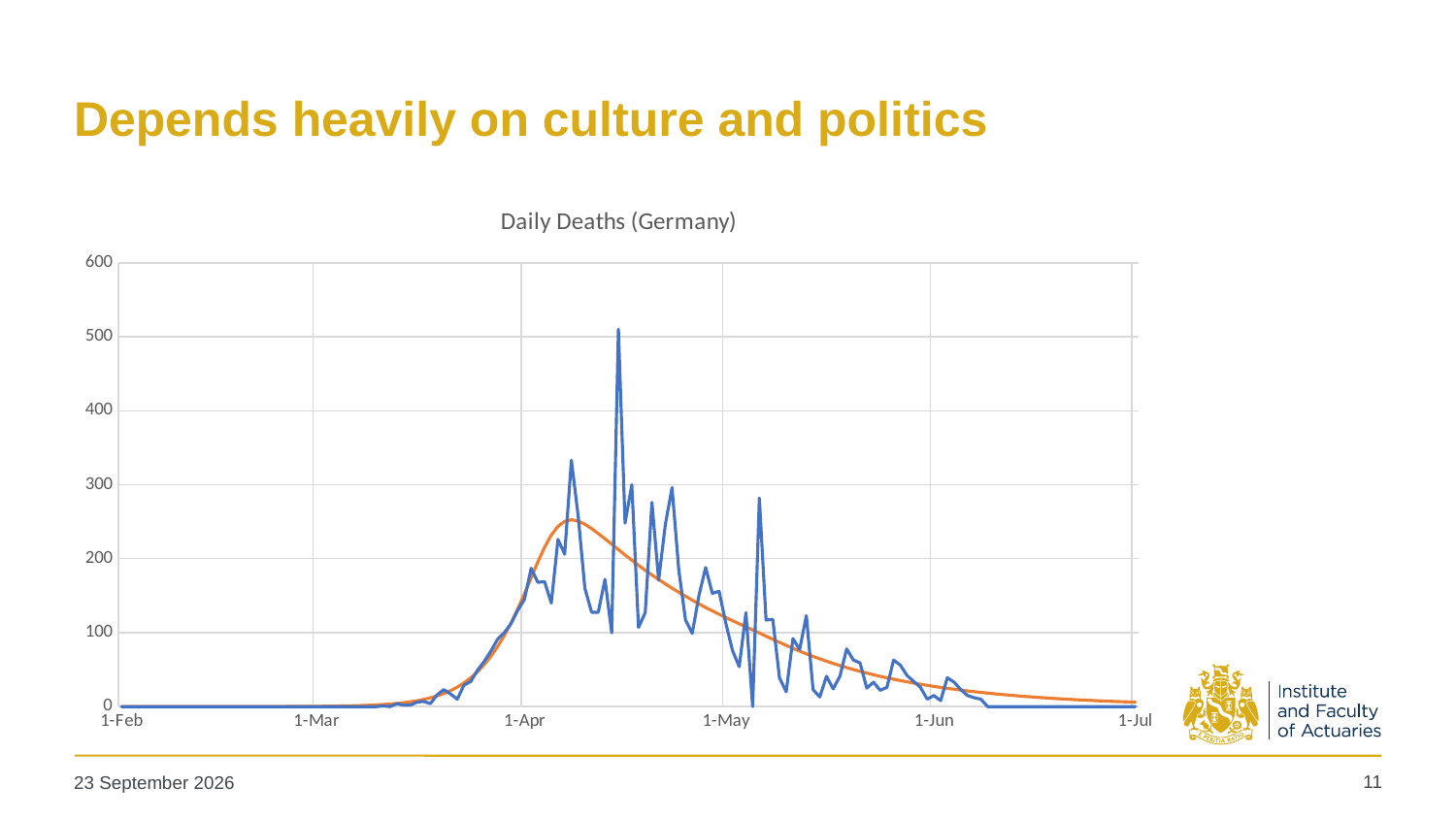
Is the peak of the orange smooth line greater or less than 200? greater Is the value of the orange line at 1-Jun greater or less than 100? less Does the orange line rise or fall between 1-May and 1-Jul? fall Is the peak of the orange smooth line greater or less than 300? less How many lines are plotted on the chart? 2 Does the orange line rise or fall between 1-Mar and 1-Apr? rise How many date labels are shown on the x axis? 6 What kind of chart is shown on the slide? line chart What is the highest value shown on the y axis? 600 What is the title of the chart? Daily Deaths (Germany)